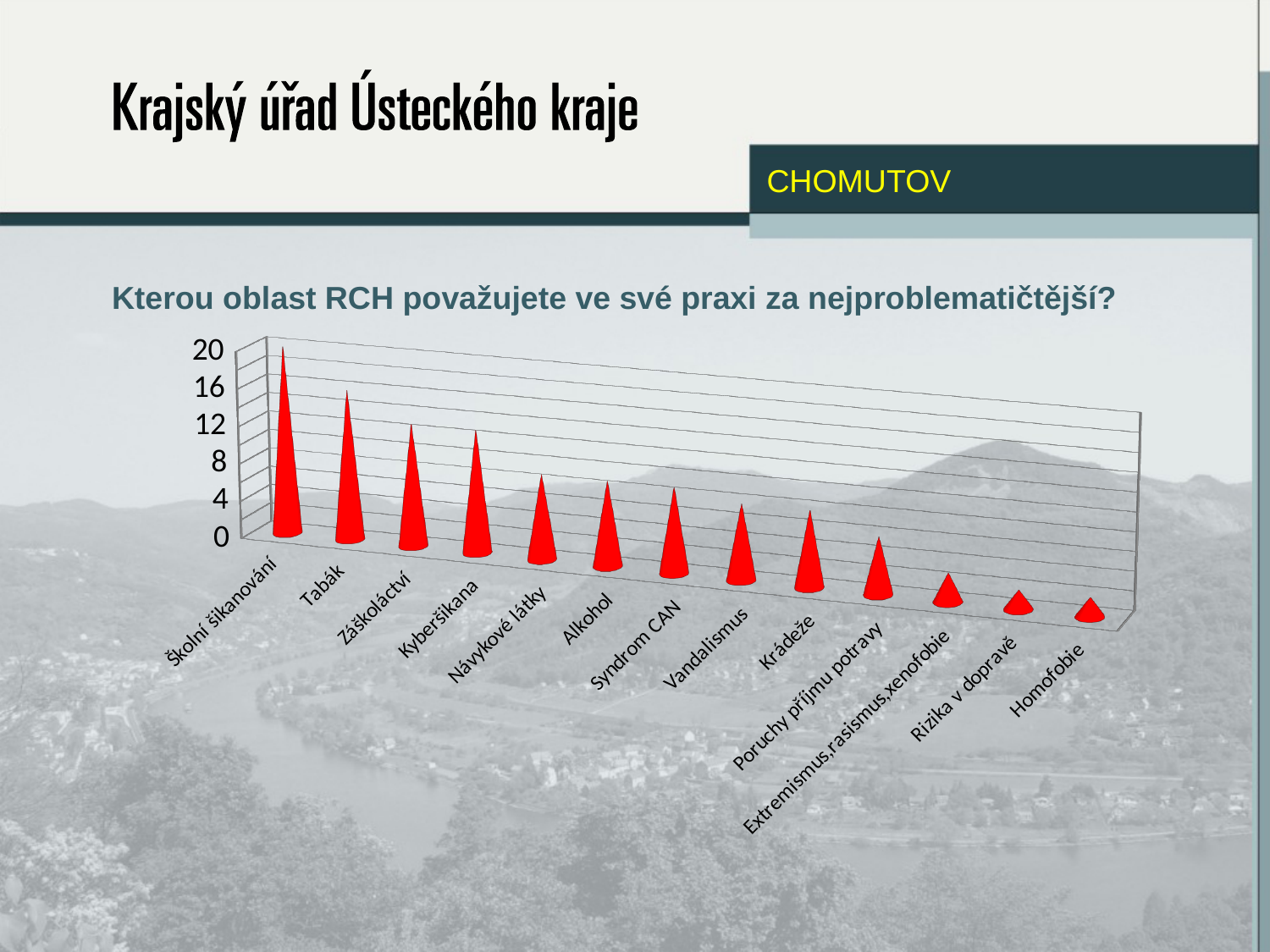
Is the value for Homofobie greater or less than 4? less Is the value for Návykové látky greater or less than 12? less Which has a larger value, Záškoláctví or Krádeže? Záškoláctví Is the value for Tabák greater or less than 12? greater What question is written as the heading above the chart? Kterou oblast RCH považujete ve své praxi za nejproblematičtější? Which has a larger value, Tabák or Alkohol? Tabák What kind of chart is shown on the slide? bar chart Do the values generally rise or fall from left to right along the x axis? fall How many categories are shown on the x axis of the chart? 13 Which category has the highest value in the chart? Školní šikanování